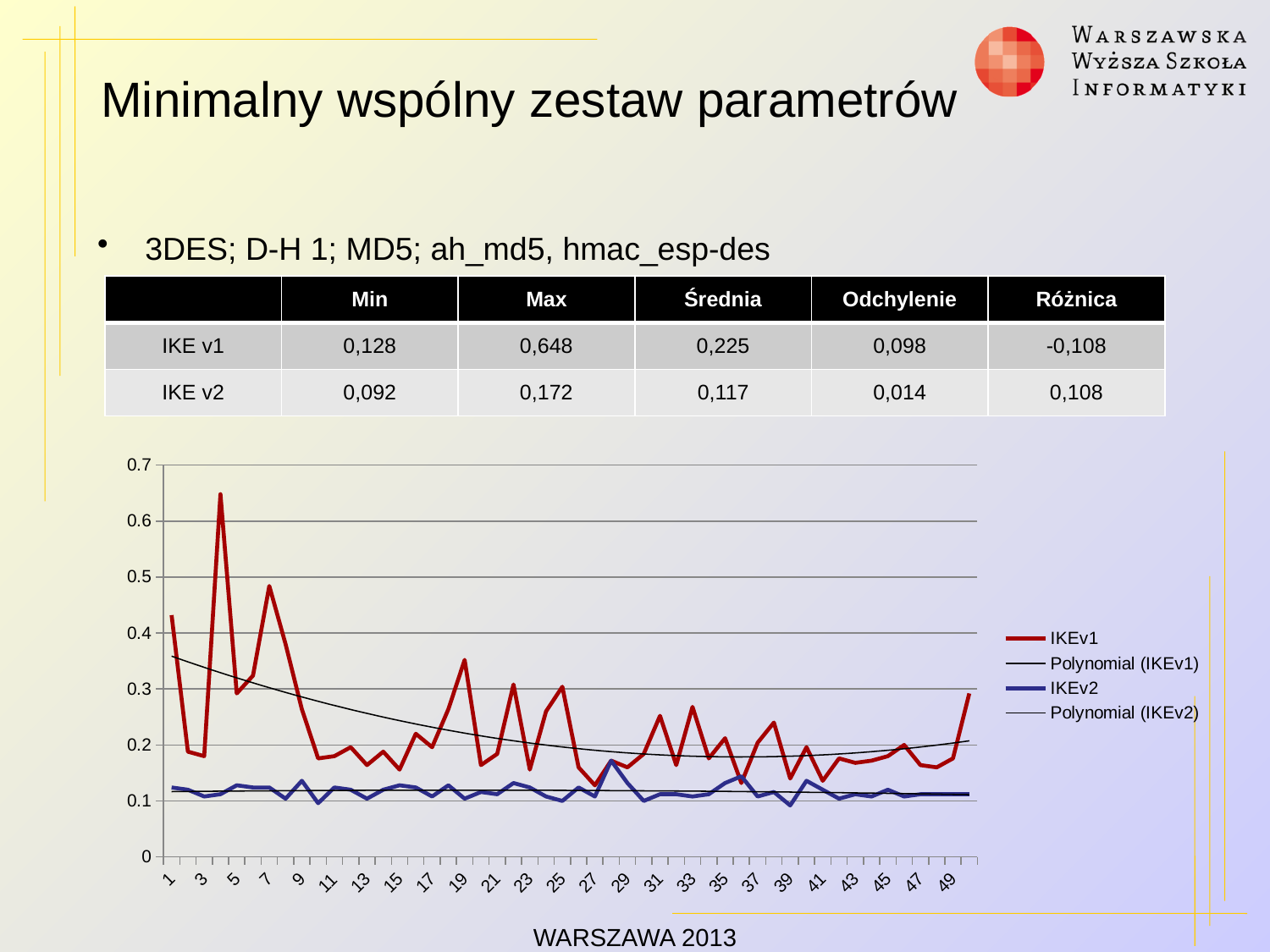
At point 1, which series has the larger value, IKEv1 or IKEv2? IKEv1 What kind of chart is shown on the slide? line chart Do the IKEv1 values generally rise or fall from left to right along the x axis? fall Is the highest value of the IKEv1 line greater or less than 0.6? greater What is the highest tick value shown on the y axis? 0.7 How many entries does the chart legend list? 4 What colour is the IKEv1 line in the chart? red Does the IKEv2 line ever rise above 0.2? No Is the value for IKEv1 at point 1 greater or less than 0.4? greater Which series reaches the highest peak on the chart, IKEv1 or IKEv2? IKEv1